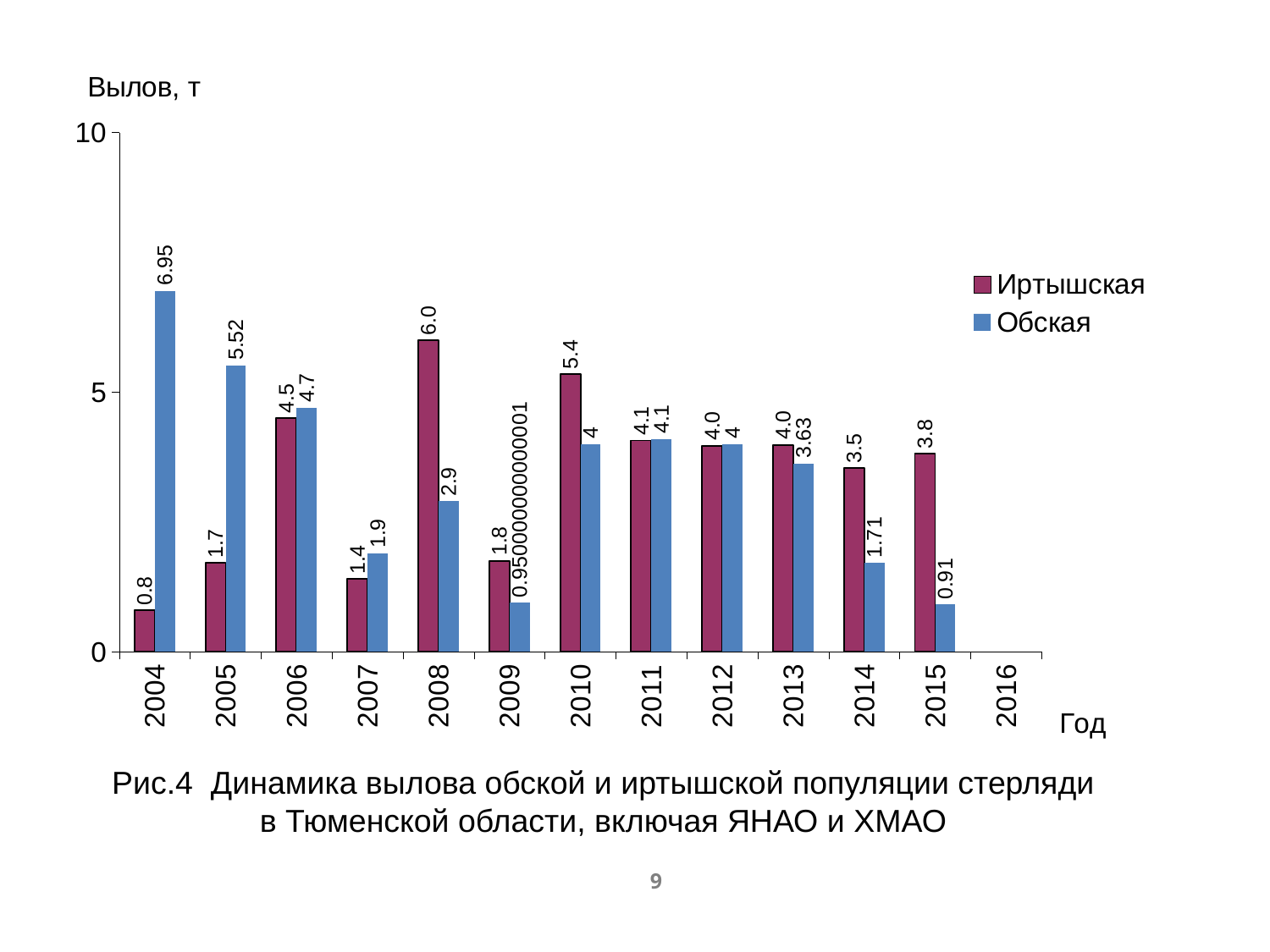
Which series has the larger value in 2006, Иртышская or Обская? Обская What is the difference between the Иртышская and Обская values in 2008? 3.1 What is the difference between the Обская and Иртышская values in 2004? 6.15 What is the value for Обская in 2004? 6.95 How many series does the legend list? 2 What is the value for Обская in 2014? 1.71 What type of chart is shown on the slide? bar chart What is the value for Иртышская in 2008? 6.0 In which year is the Иртышская value highest? 2008 In which year is the Иртышская value lowest? 2004 Is the value for Иртышская in 2010 greater or less than 5? greater Do the Обская values rise or fall from 2004 to 2007? fall